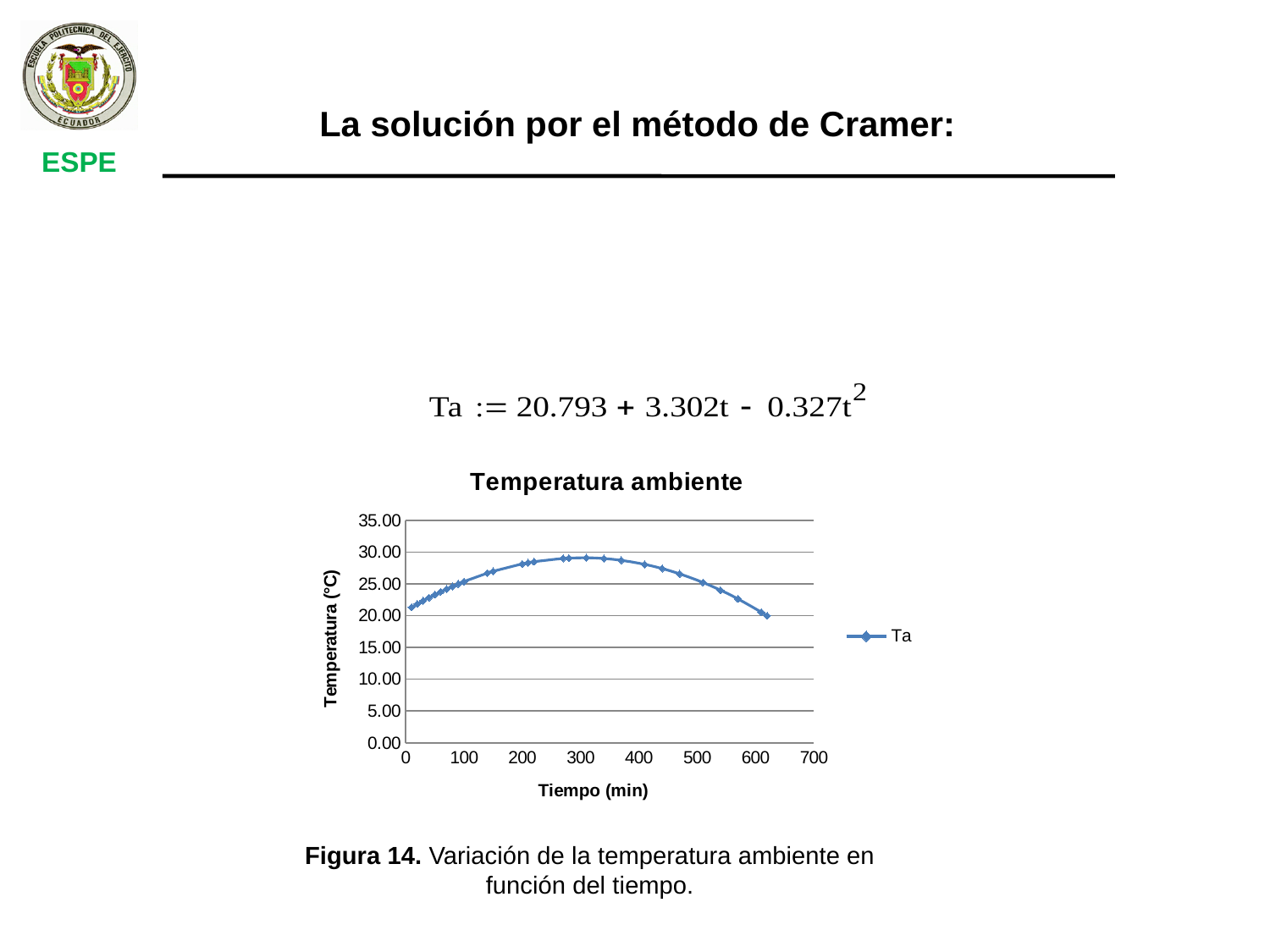
Do the Ta values rise or fall between 400 and 600 min? fall What is the title of the chart? Temperatura ambiente Is the value of Ta at 300 min greater or less than 25? greater Is the value of Ta at 600 min greater or less than 25? less Is the value of Ta at 500 min greater or less than 20? greater Which is larger, the value of Ta at 300 min or at 600 min? 300 min How many series does the chart legend list? 1 What is the name of the series shown in the legend? Ta Which is larger, the value of Ta at 50 min or at 200 min? 200 min Do the Ta values rise or fall between 0 and 250 min? rise What kind of chart is shown on the slide? line chart